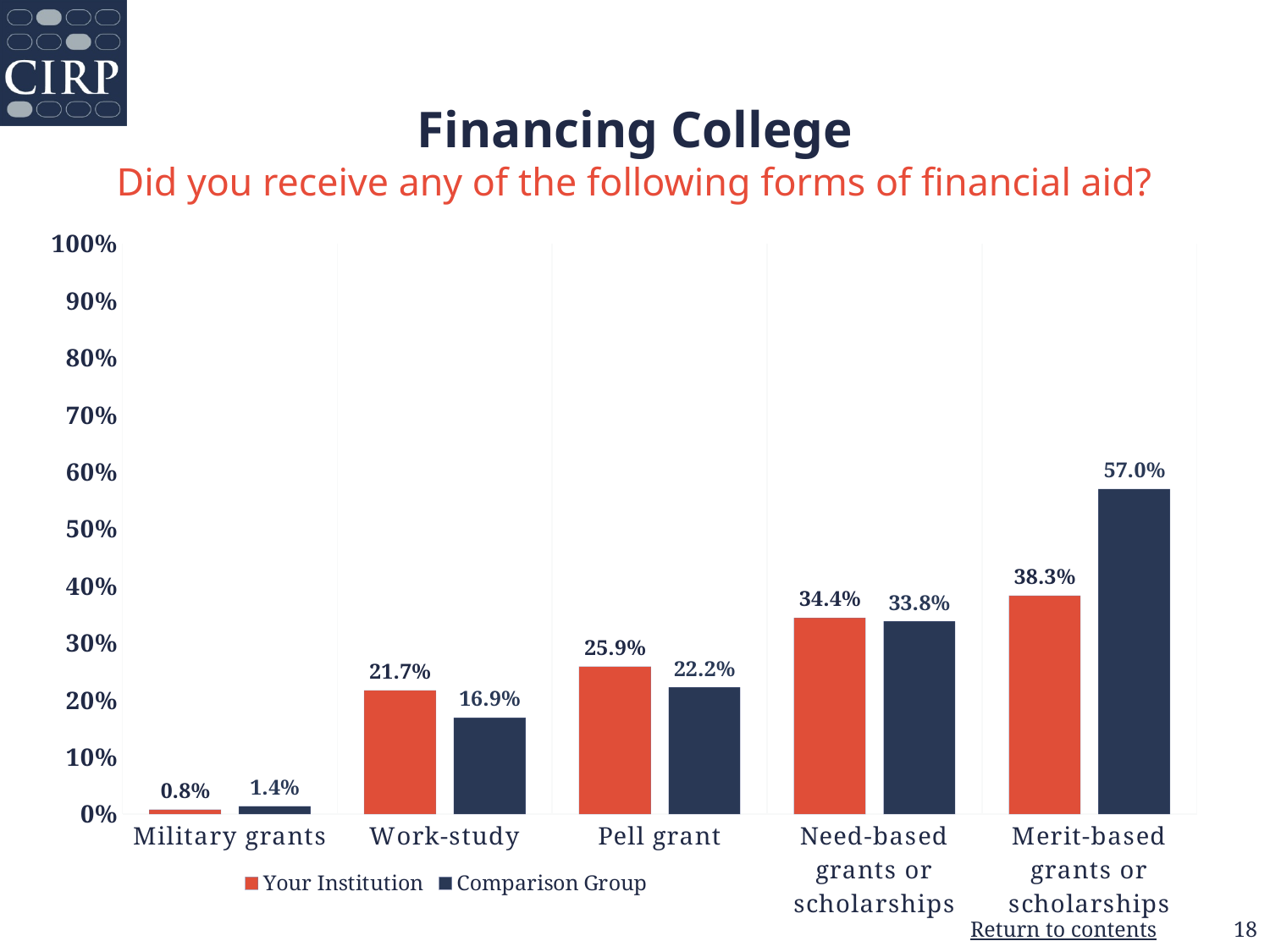
How many financial aid categories are shown on the x axis? 5 What is the difference between the Comparison Group and Your Institution values for Merit-based grants or scholarships? 18.7% What is the Your Institution value for Work-study? 21.7% What percentage of Your Institution received a Pell grant? 25.9% What kind of chart is shown on the slide? Bar chart For Need-based grants or scholarships, which is larger: Your Institution or Comparison Group? Your Institution How many series does the legend list? 2 Which category has the lowest value for Your Institution? Military grants What is the Comparison Group value for Merit-based grants or scholarships? 57.0% What is the difference between Your Institution and the Comparison Group for Work-study? 4.8% Is the Comparison Group value for Merit-based grants or scholarships greater or less than 50%? greater Which category has the highest value for the Comparison Group? Merit-based grants or scholarships